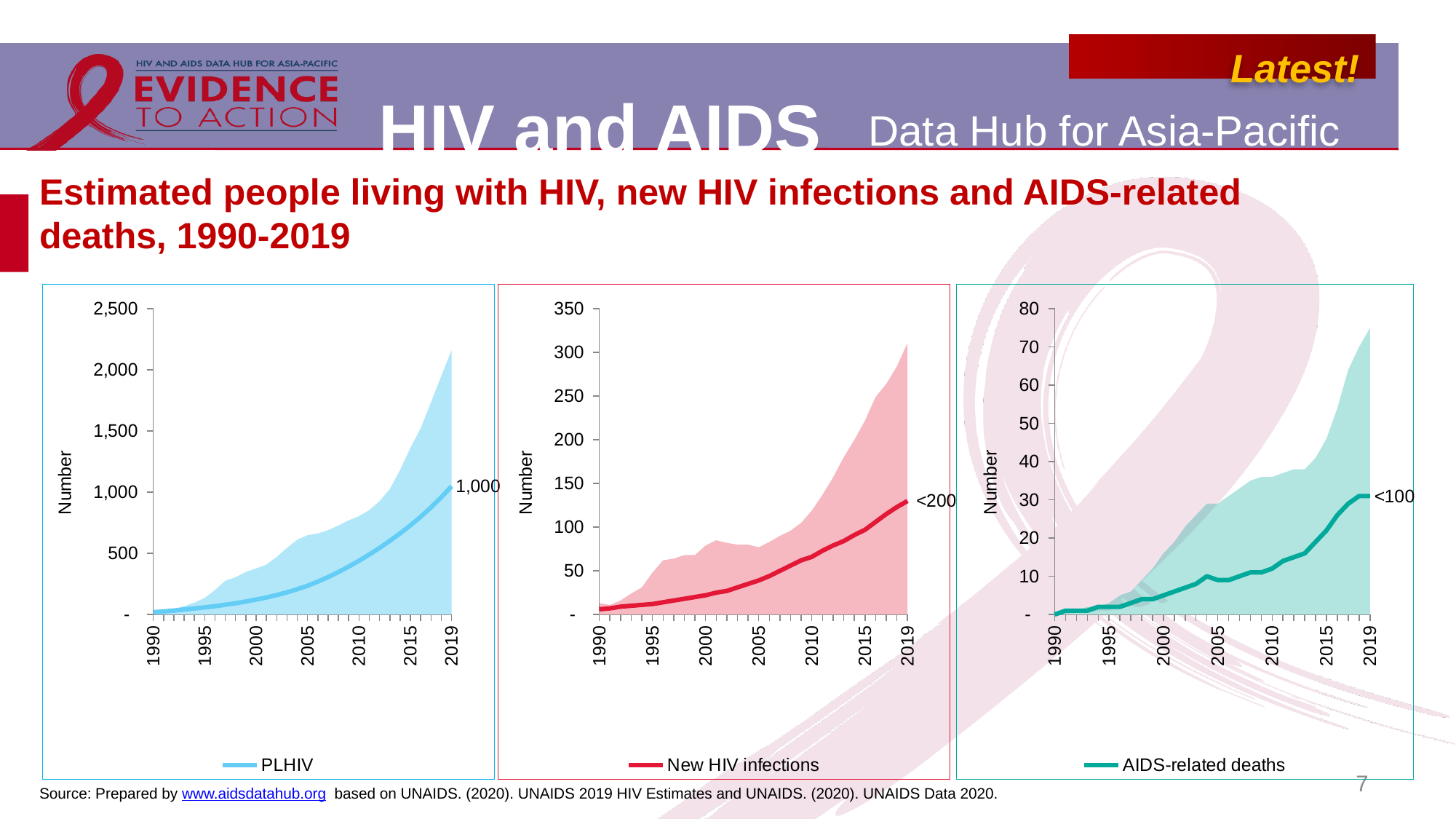
What kind of chart is the left chart (PLHIV)? combination area and line chart What is the legend entry of the middle chart? New HIV infections On the left chart (PLHIV), in which year is the line at its highest? 2019 On the right chart (AIDS-related deaths), what value is labelled at the end of the line in 2019? <100 On the left chart (PLHIV), is the value for 2010 greater or less than 500? less On the left chart (PLHIV), what value is labelled at the end of the line in 2019? 1,000 On the middle chart (New HIV infections), what value is labelled at the end of the line in 2019? <200 How many series does the legend of the right chart list? 1 On the middle chart (New HIV infections), is the value for 2010 greater or less than 50? greater On the right chart (AIDS-related deaths), does the line rise or fall from 1990 to 2019? rise On the middle chart (New HIV infections), does the line rise or fall from 1990 to 2019? rise